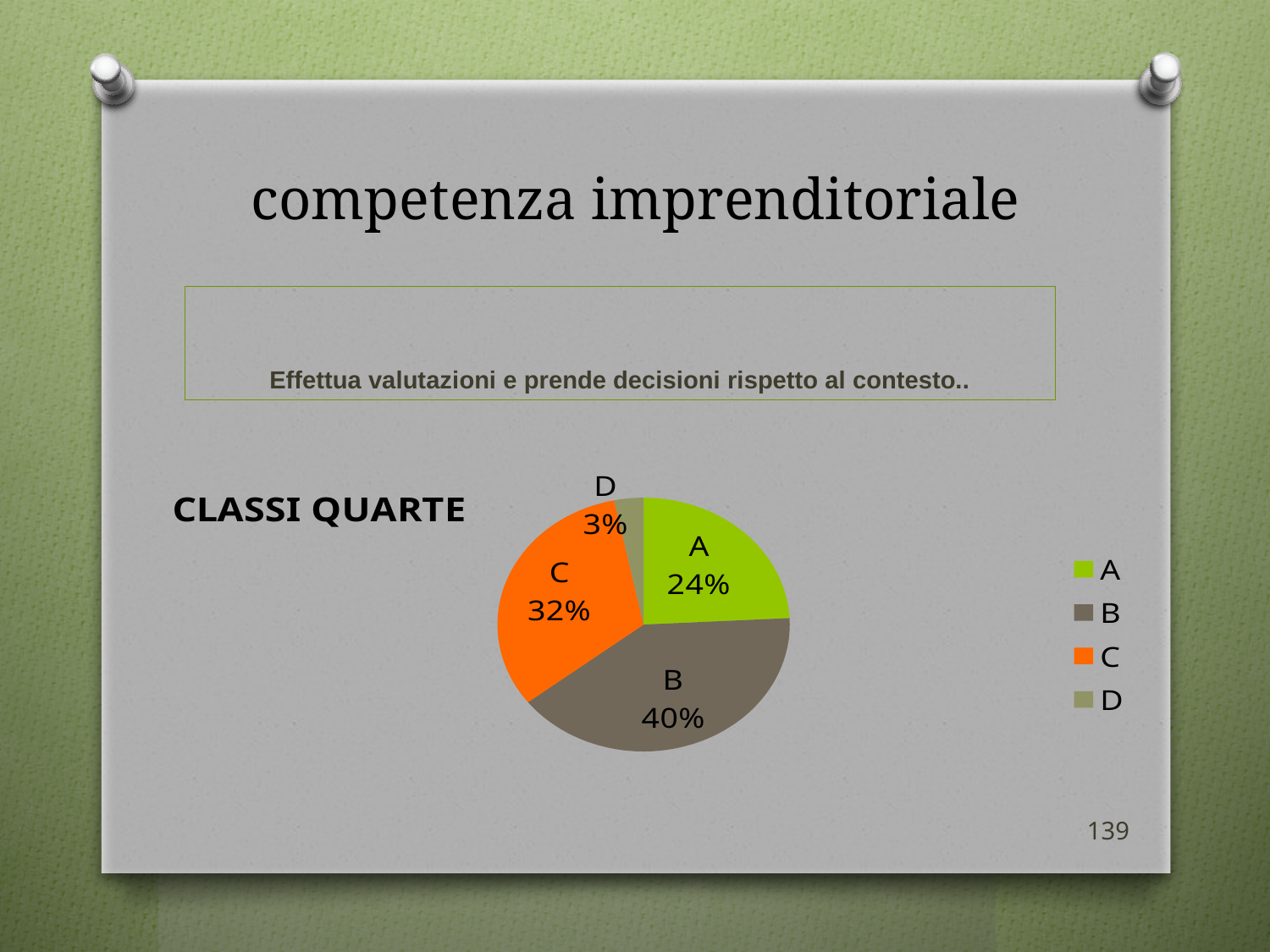
What is the difference in percentage points between slice B and slice C? 8 What kind of chart is shown on the slide? pie chart How many slices does the pie chart have? 4 Which slice of the pie chart is the smallest? D What percentage does slice A represent in the pie chart? 24% How many entries does the legend list? 4 Which is larger, slice A or slice C? C What percentage does slice D represent in the pie chart? 3% What colour is slice C in the pie chart? orange What percentage does slice C represent in the pie chart? 32% Which slice of the pie chart is the largest? B What percentage does slice B represent in the pie chart? 40%